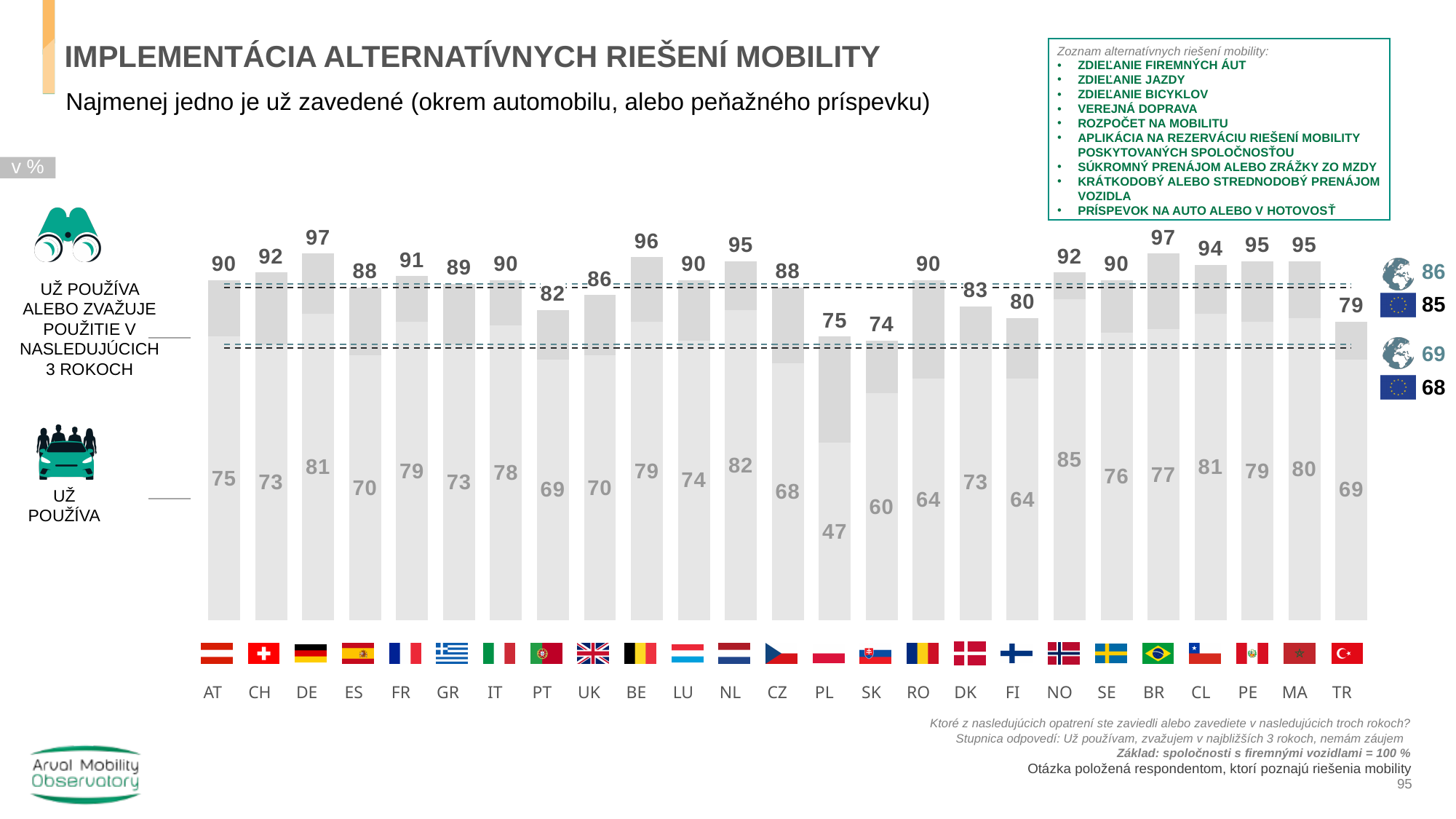
Which country has the lowest value in the 'UŽ POUŽÍVA ALEBO ZVAŽUJE POUŽITIE V NASLEDUJÚCICH 3 ROKOCH' series? SK What is the value for DE in the 'UŽ POUŽÍVA ALEBO ZVAŽUJE POUŽITIE V NASLEDUJÚCICH 3 ROKOCH' series? 97 How many countries are shown on the x axis of the chart? 25 What is the EU reference value shown for the 'UŽ POUŽÍVA' series on the right of the chart? 68 What is the 'UŽ POUŽÍVA' value for NO? 85 Which has a higher 'UŽ POUŽÍVA' value, NL or CZ? NL What is the difference between the 'UŽ POUŽÍVA ALEBO ZVAŽUJE' value and the 'UŽ POUŽÍVA' value for PL? 28 What is the value for PL in the 'UŽ POUŽÍVA' series? 47 What kind of chart is shown on the slide? Bar chart Which country has the highest 'UŽ POUŽÍVA' value? NO Which country has the lowest 'UŽ POUŽÍVA' value? PL